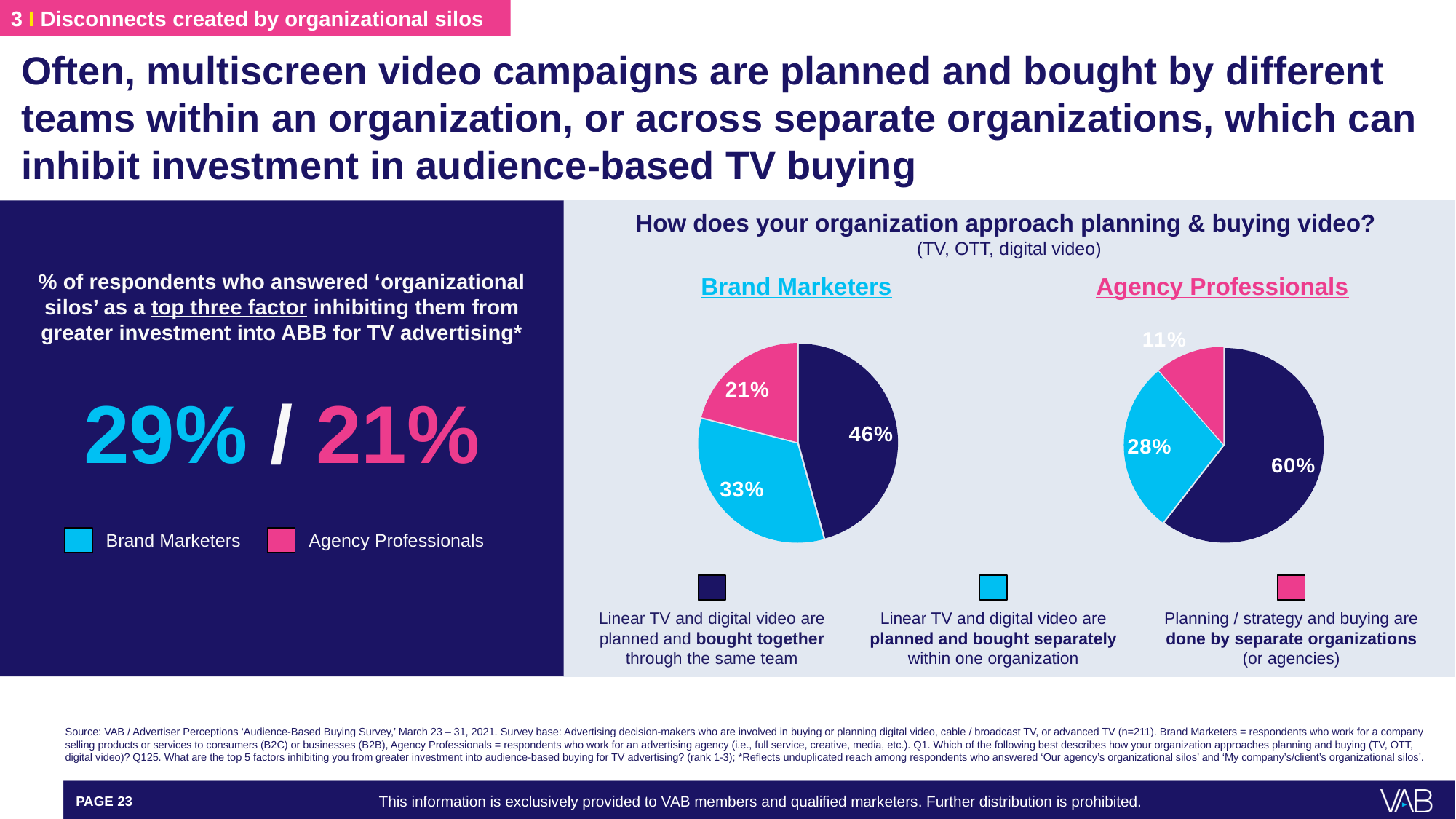
In the Brand Marketers pie chart, what share of respondents said linear TV and digital video are planned and bought together through the same team? 46% In the Brand Marketers pie chart, what share of respondents said linear TV and digital video are planned and bought separately within one organization? 33% In the Brand Marketers pie chart, which response has the smallest share? Planning / strategy and buying are done by separate organizations (or agencies) Which group has a larger share for 'done by separate organizations (or agencies)': Brand Marketers or Agency Professionals? Brand Marketers In the Agency Professionals pie chart, what share of respondents said linear TV and digital video are planned and bought separately within one organization? 28% In the Agency Professionals pie chart, what share of respondents said planning / strategy and buying are done by separate organizations (or agencies)? 11% In the Agency Professionals pie chart, which response has the largest share? Linear TV and digital video are planned and bought together through the same team What type of chart is used to show how organizations approach planning & buying video? Pie chart How many slices does the Brand Marketers pie chart have? 3 How many categories does the legend below the pie charts list? 3 What is the difference between the Agency Professionals and Brand Marketers shares for 'planned and bought together through the same team'? 14 percentage points What colour represents 'Linear TV and digital video are planned and bought separately within one organization' in the pie charts? Light blue (cyan)